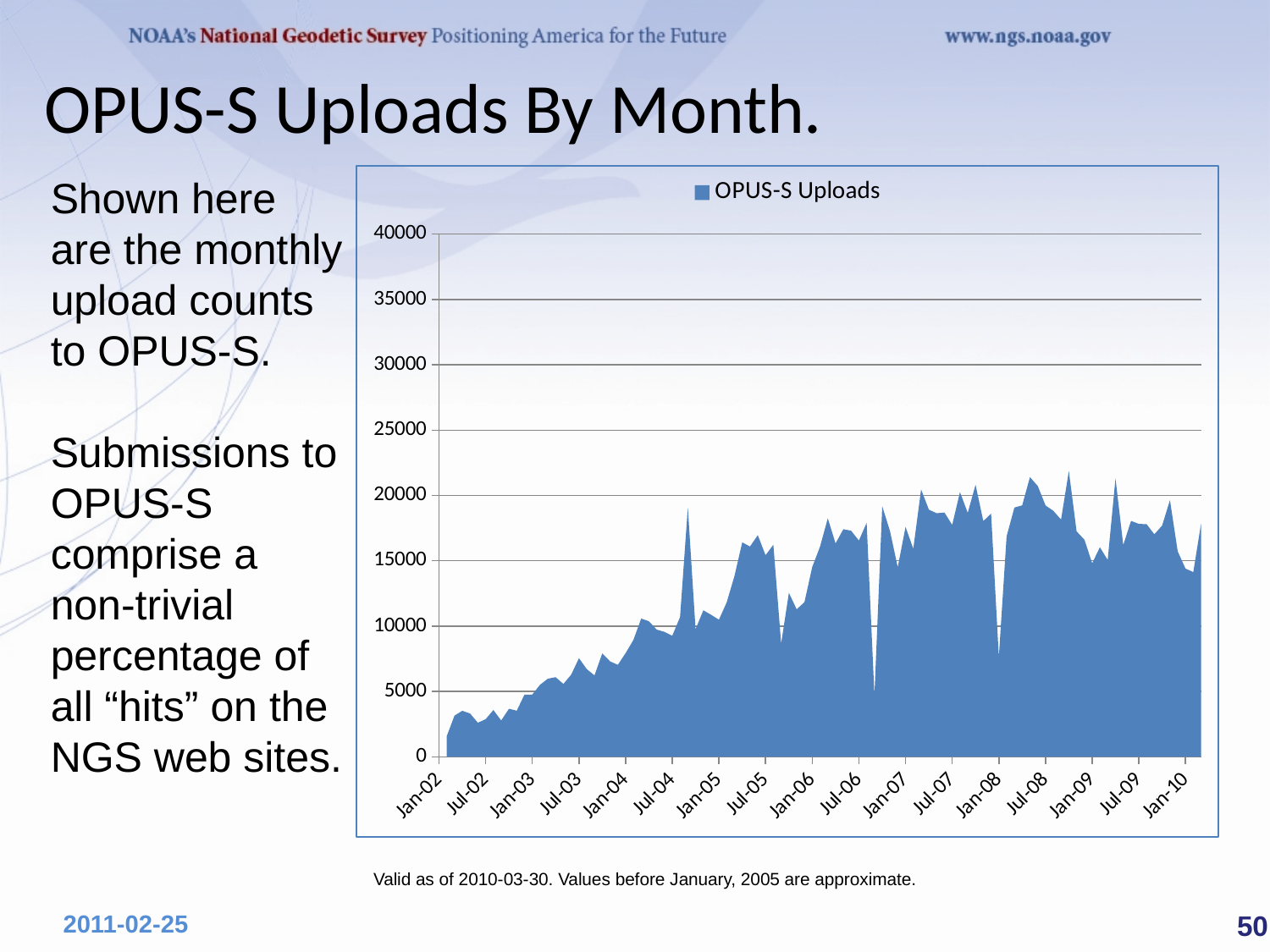
Is the value for Jul-08 greater or less than 25000? less Is the value for Jul-03 greater or less than 5000? greater Is the value for Jan-02 greater or less than 5000? less Overall, do OPUS-S uploads rise or fall from Jan-02 to Jan-10? rise What is the highest value shown on the chart's vertical axis? 40000 What kind of chart is shown on the slide? area chart How many series does the chart legend list? 1 Which is larger, the value for Jul-03 or the value for Jul-06? Jul-06 Which labelled month on the x axis has the lowest OPUS-S upload count? Jan-02 What is the name of the series shown in the chart legend? OPUS-S Uploads